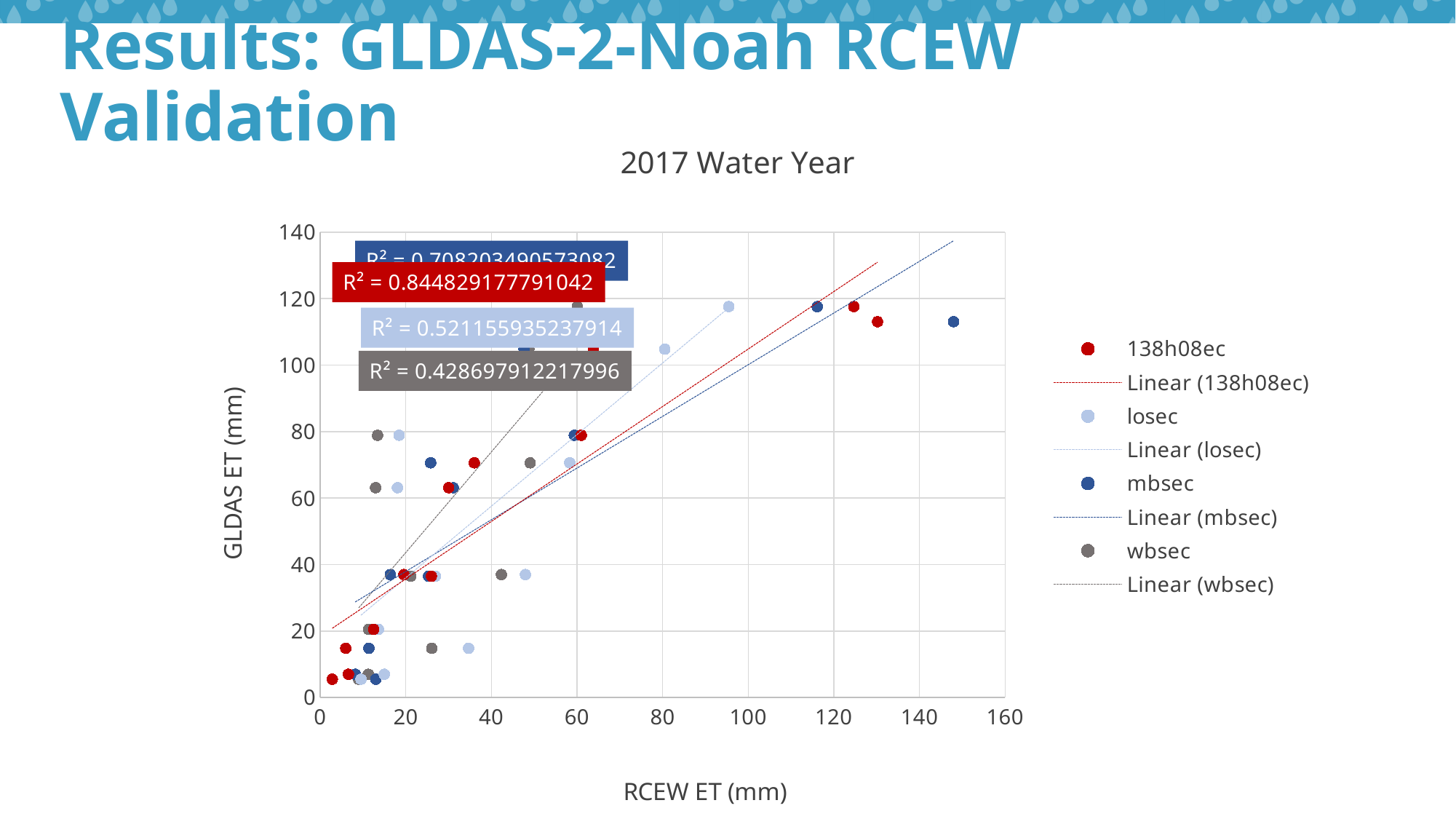
What R² value is shown in the red box? 0.844829177791042 Which series has the point with the largest RCEW ET value? mbsec What is the lowest R² value shown on the chart? 0.428697912217996 Is the GLDAS ET value for the mbsec point with the largest RCEW ET greater or less than 120? less What R² value is shown in the light blue box? 0.521155935237914 What is the label of the x axis? RCEW ET (mm) Is the R² value in the red box greater or less than the R² value in the grey box? greater What is the highest R² value shown on the chart? 0.844829177791042 What is the title of the chart? 2017 Water Year Do GLDAS ET values generally rise or fall as RCEW ET increases? rise What kind of chart is shown on the slide? scatter chart How many entries does the chart legend list? 8